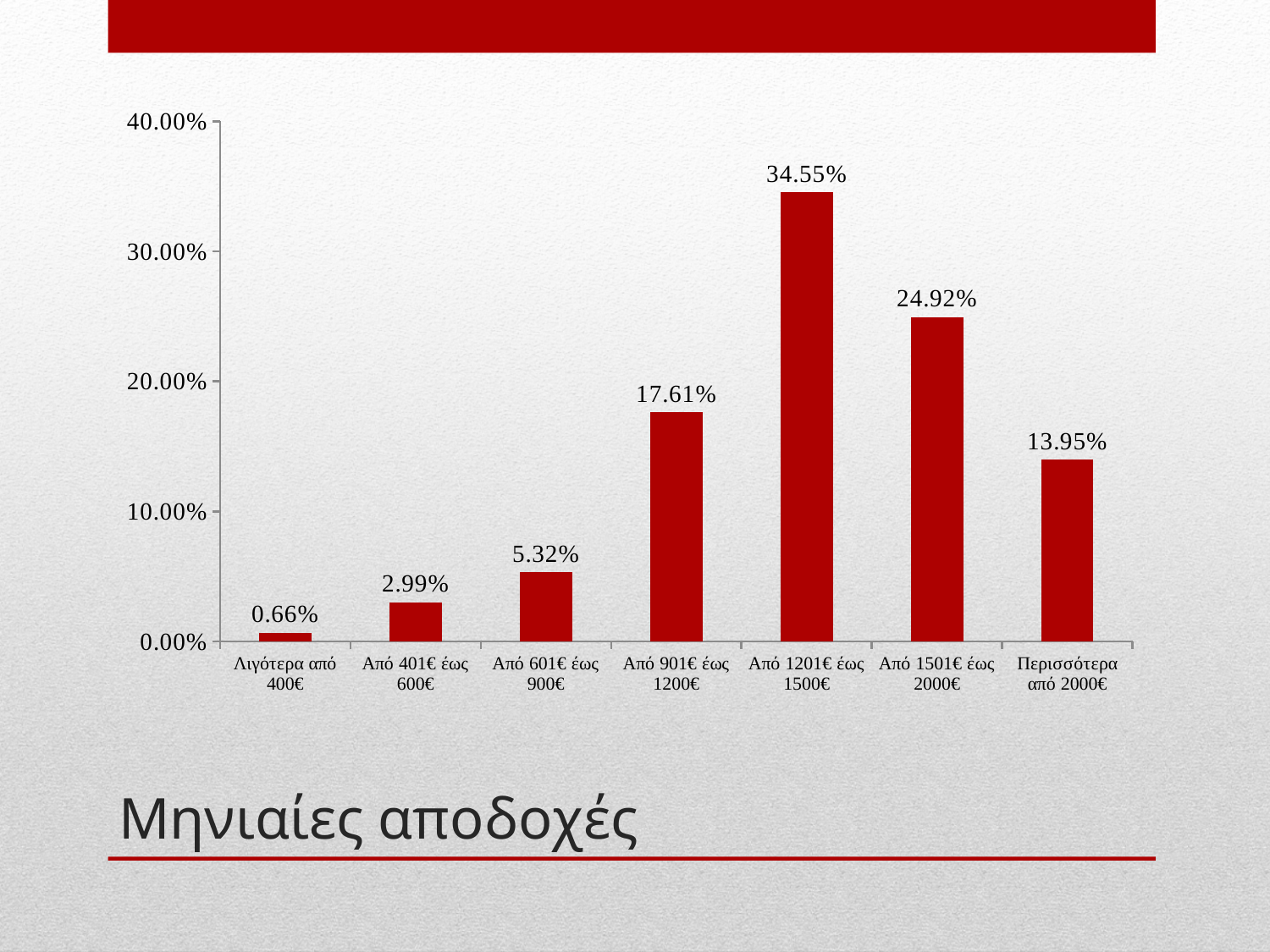
What is the difference between the values for 'Από 1201€ έως 1500€' and 'Από 1501€ έως 2000€'? 9.63% Is the value for 'Από 1501€ έως 2000€' greater or less than 20.00%? greater Do the values rise or fall from 'Λιγότερα από 400€' to 'Από 1201€ έως 1500€'? rise What kind of chart is shown on the slide? bar chart What is the value for the category 'Περισσότερα από 2000€'? 13.95% What is the value for the category 'Λιγότερα από 400€'? 0.66% Which category has the lowest value? Λιγότερα από 400€ Which category has the highest value? Από 1201€ έως 1500€ Which is larger, the value for 'Από 901€ έως 1200€' or the value for 'Περισσότερα από 2000€'? Από 901€ έως 1200€ How many categories are shown on the x axis? 7 What is the value for the category 'Από 1201€ έως 1500€'? 34.55% What is the title shown on the slide? Μηνιαίες αποδοχές